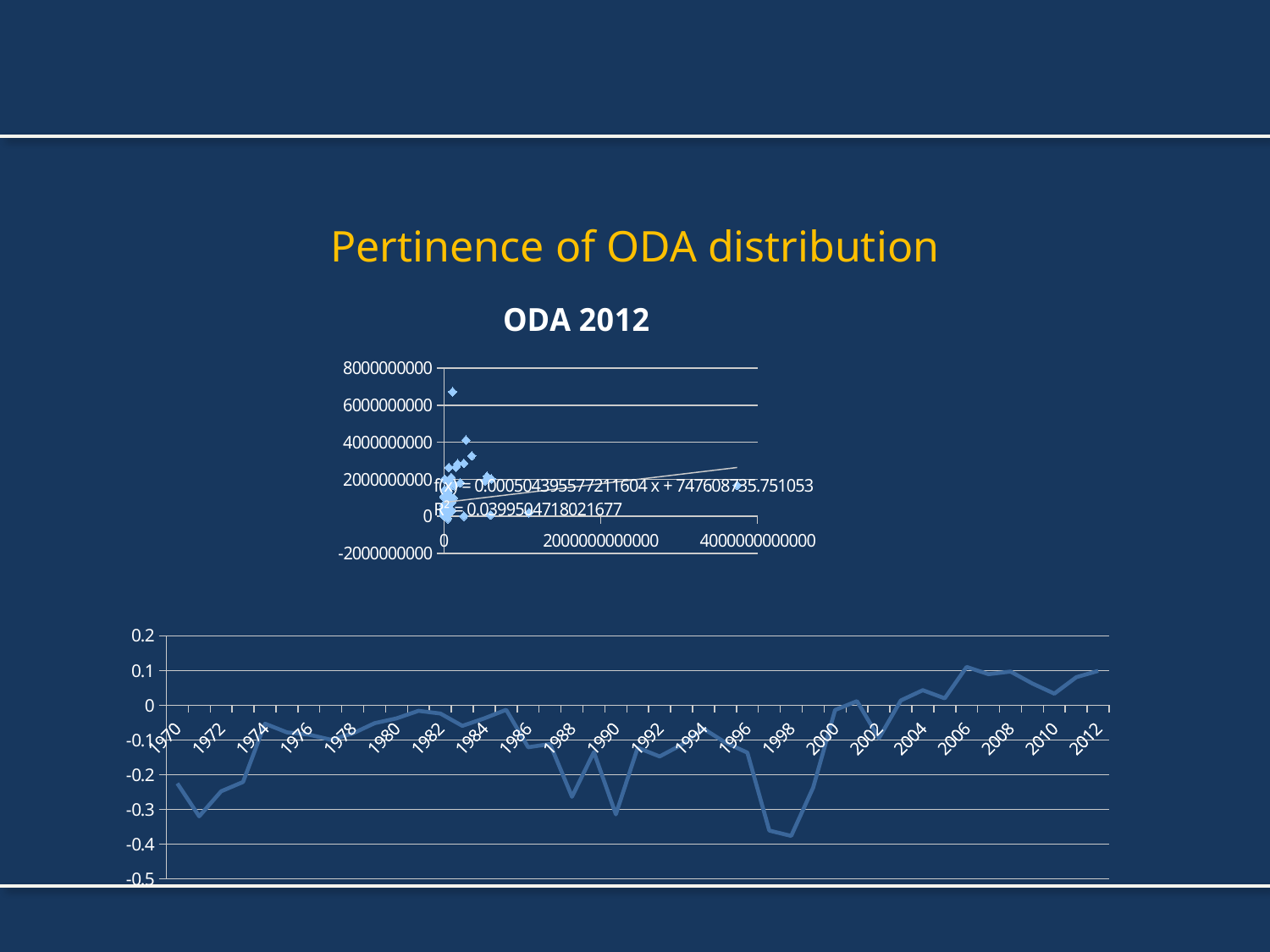
In the lower chart (years 1970 to 2012), is the value for 1998 greater or less than -0.3? less In the chart titled "ODA 2012", what is the highest value shown on the y axis? 8000000000 In the lower chart (years 1970 to 2012), which is larger, the value for 2006 or the value for 1970? 2006 In the chart titled "ODA 2012", what R² value is printed for the trendline? 0.0399504718021677 What kind of chart is the lower chart on the slide (the one with years from 1970 to 2012)? line chart In the lower chart (years 1970 to 2012), is the value for 1988 greater or less than -0.2? less In the lower chart (years 1970 to 2012), is the value for 2004 greater or less than 0? greater What kind of chart is the chart titled "ODA 2012"? scatter chart What is the title of the upper chart on the slide? ODA 2012 In the lower chart, do the values overall rise or fall from 1970 to 2012? rise In the lower chart (years 1970 to 2012), which is larger, the value for 1998 or the value for 1988? 1988